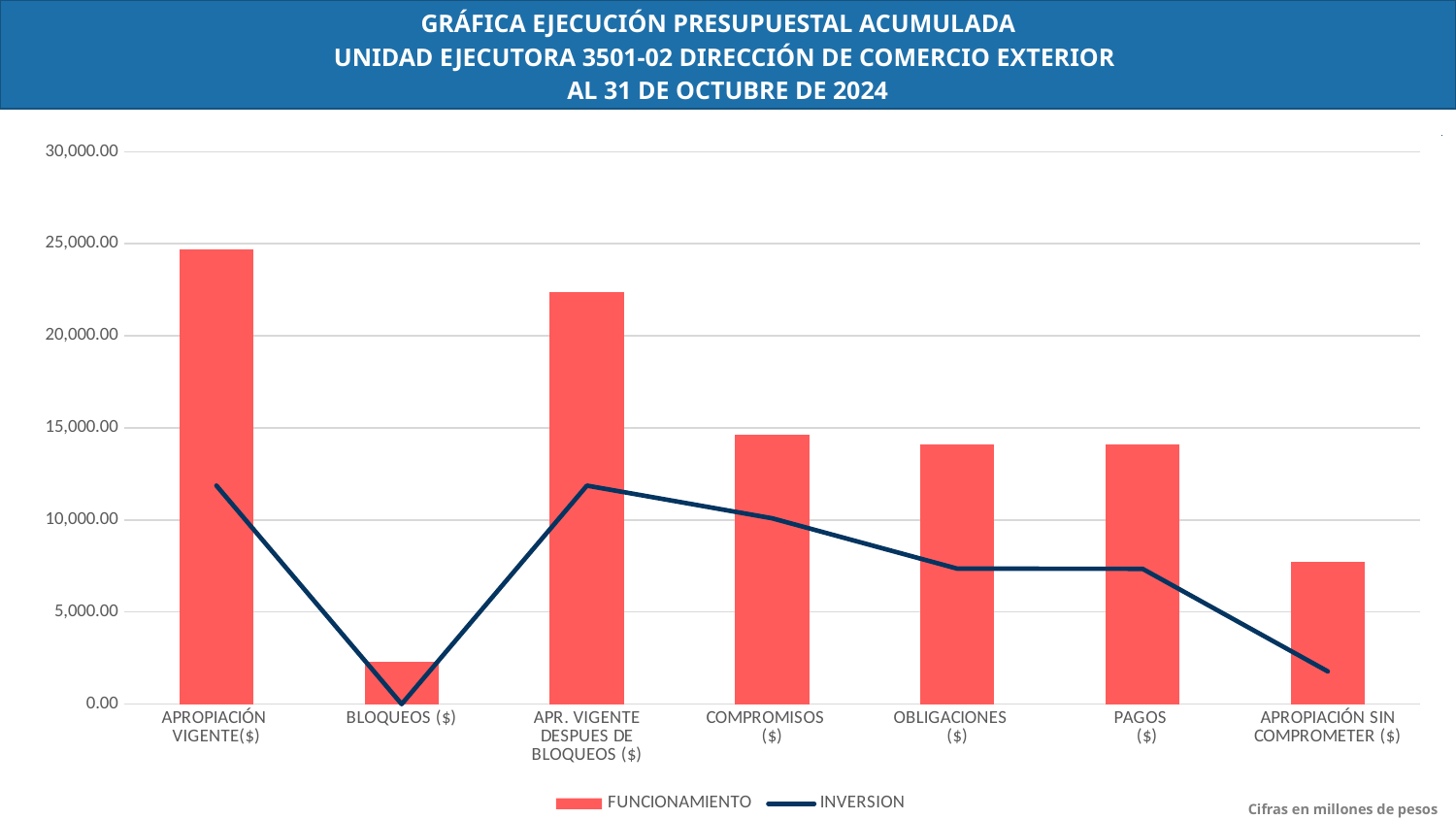
Does the INVERSION line rise or fall from COMPROMISOS ($) to APROPIACIÓN SIN COMPROMETER ($)? It falls Is the FUNCIONAMIENTO value for APROPIACIÓN VIGENTE($) greater or less than 20,000.00? greater Is the FUNCIONAMIENTO value for OBLIGACIONES ($) greater or less than 15,000.00? less According to the note at the bottom right, in what units are the figures expressed? Millones de pesos Which category has the highest FUNCIONAMIENTO bar? APROPIACIÓN VIGENTE($) Is the INVERSION value for APROPIACIÓN SIN COMPROMETER ($) greater or less than 5,000.00? less Which is larger for FUNCIONAMIENTO: COMPROMISOS ($) or APROPIACIÓN SIN COMPROMETER ($)? COMPROMISOS ($) Which category has the lowest FUNCIONAMIENTO bar? BLOQUEOS ($) How many series does the legend list? 2 What kind of chart is shown on the slide? A combined bar and line chart How many categories are shown along the x axis? 7 Which category has the lowest INVERSION value? BLOQUEOS ($)